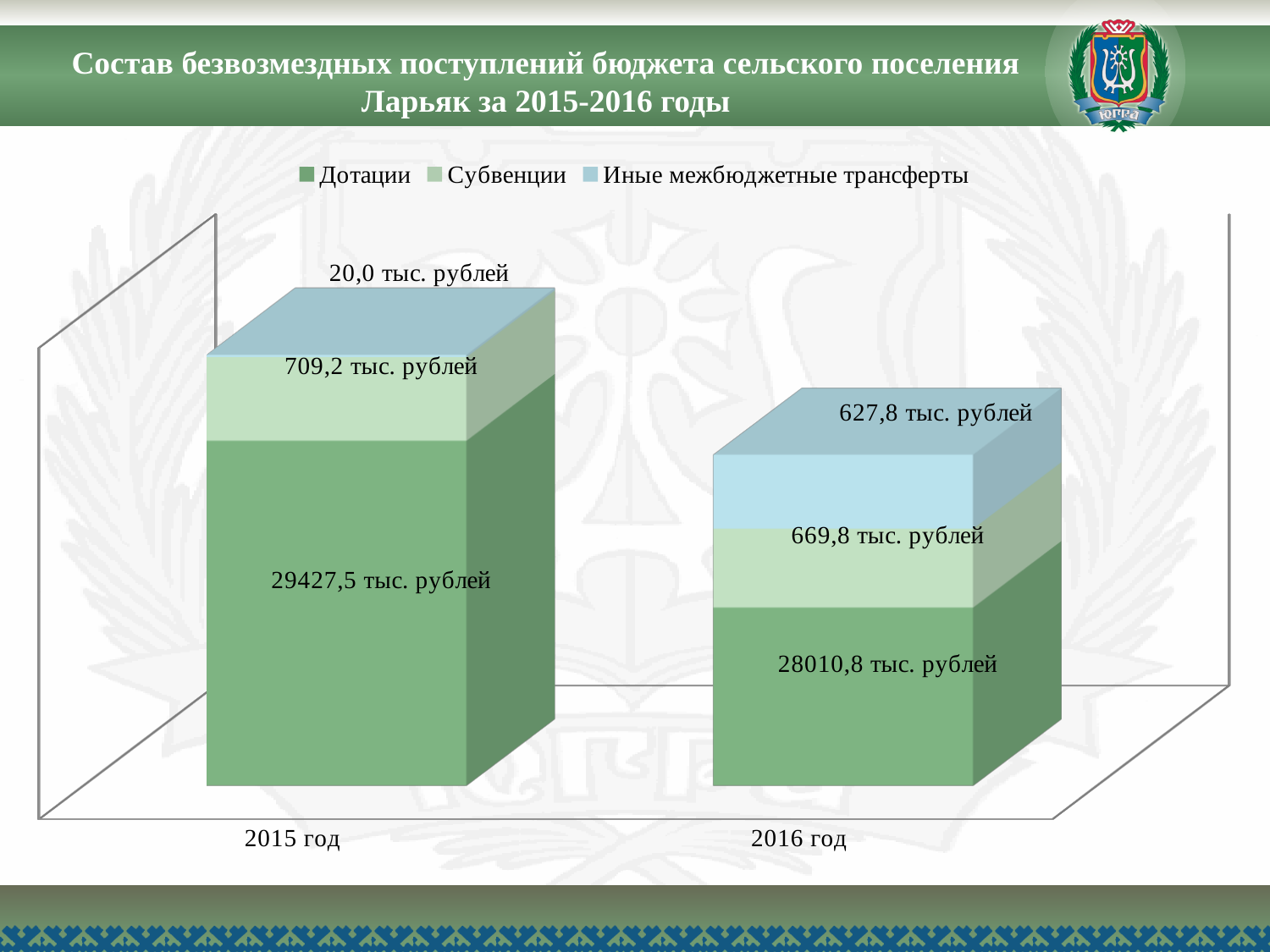
What is the total of the stacked bar for 2016 год? 29308,4 тыс. рублей By how much did Дотации decrease from 2015 год to 2016 год? 1416,7 тыс. рублей What is the value of Субвенции for 2016 год? 669,8 тыс. рублей What is the difference in Иные межбюджетные трансферты between 2016 год and 2015 год? 607,8 тыс. рублей How many categories are shown on the x axis? 2 What is the value of Иные межбюджетные трансферты for 2016 год? 627,8 тыс. рублей What is the value of Иные межбюджетные трансферты for 2015 год? 20,0 тыс. рублей What kind of chart is shown on the slide? Stacked bar chart What is the total of the stacked bar for 2015 год? 30156,7 тыс. рублей How many series does the legend list? 3 Which year has the higher value for Дотации? 2015 год What is the value of Дотации for 2015 год? 29427,5 тыс. рублей